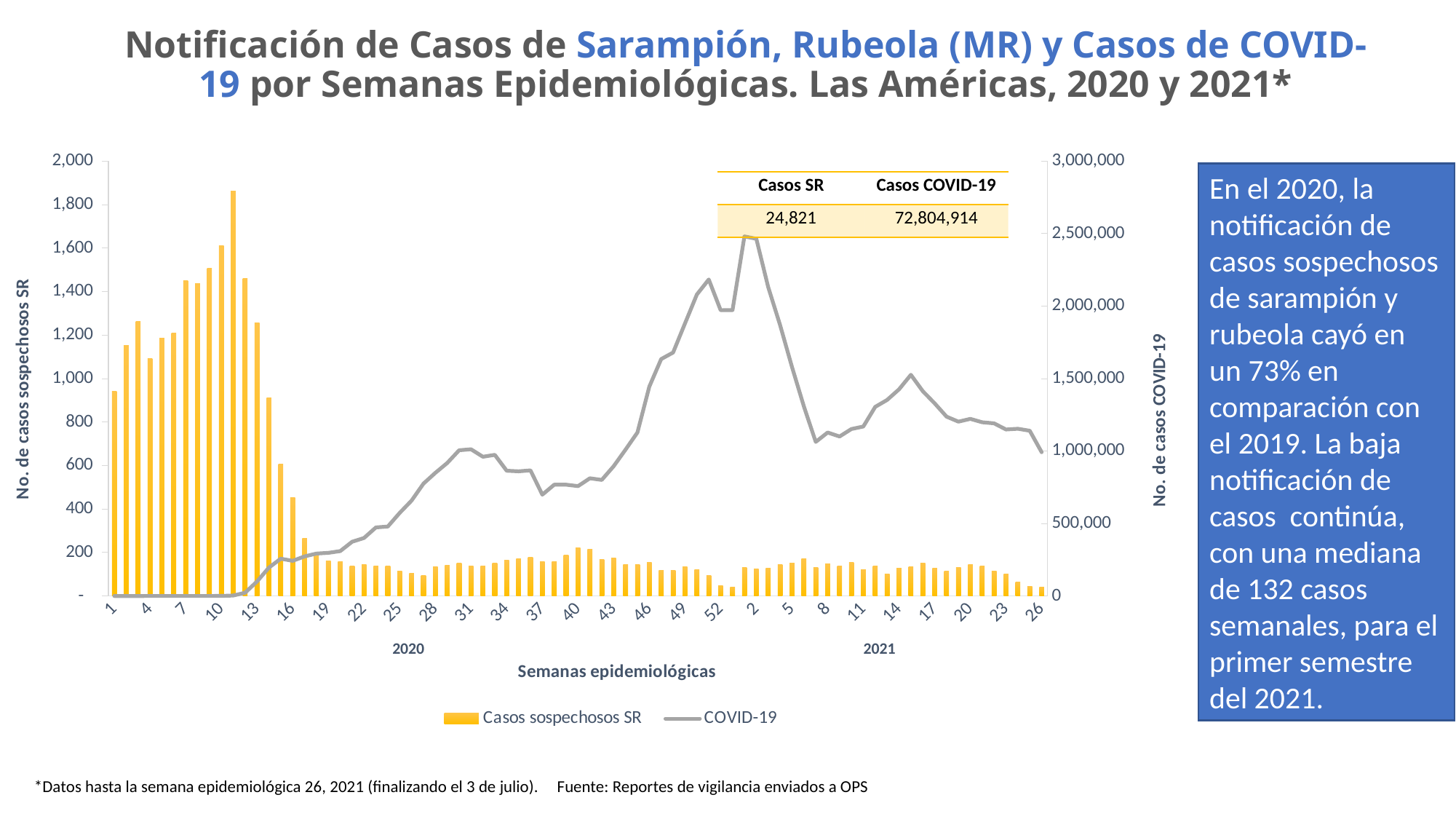
Do the Casos sospechosos SR bars rise or fall from week 12 to week 18 of 2020? Fall What are the two series named in the chart legend? Casos sospechosos SR and COVID-19 In which epidemiological week of 2020 is the bar for Casos sospechosos SR the highest? Week 11 According to the table inset in the chart, what is the total of Casos COVID-19? 72,804,914 How many series does the chart legend list? 2 According to the table inset in the chart, what is the total of Casos SR? 24,821 Is the COVID-19 value in week 2 of 2021 greater or less than 2,000,000? greater What is the title of the left vertical axis of the chart? No. de casos sospechosos SR Which is larger, the Casos sospechosos SR bar for week 1 of 2020 or the bar for week 1 of 2021? Week 1 of 2020 What kind of chart is shown on the slide? A combination bar and line chart Is the value of Casos sospechosos SR in week 12 of 2020 greater or less than 1,600? less Is the COVID-19 value in week 37 of 2020 greater or less than 1,000,000? less